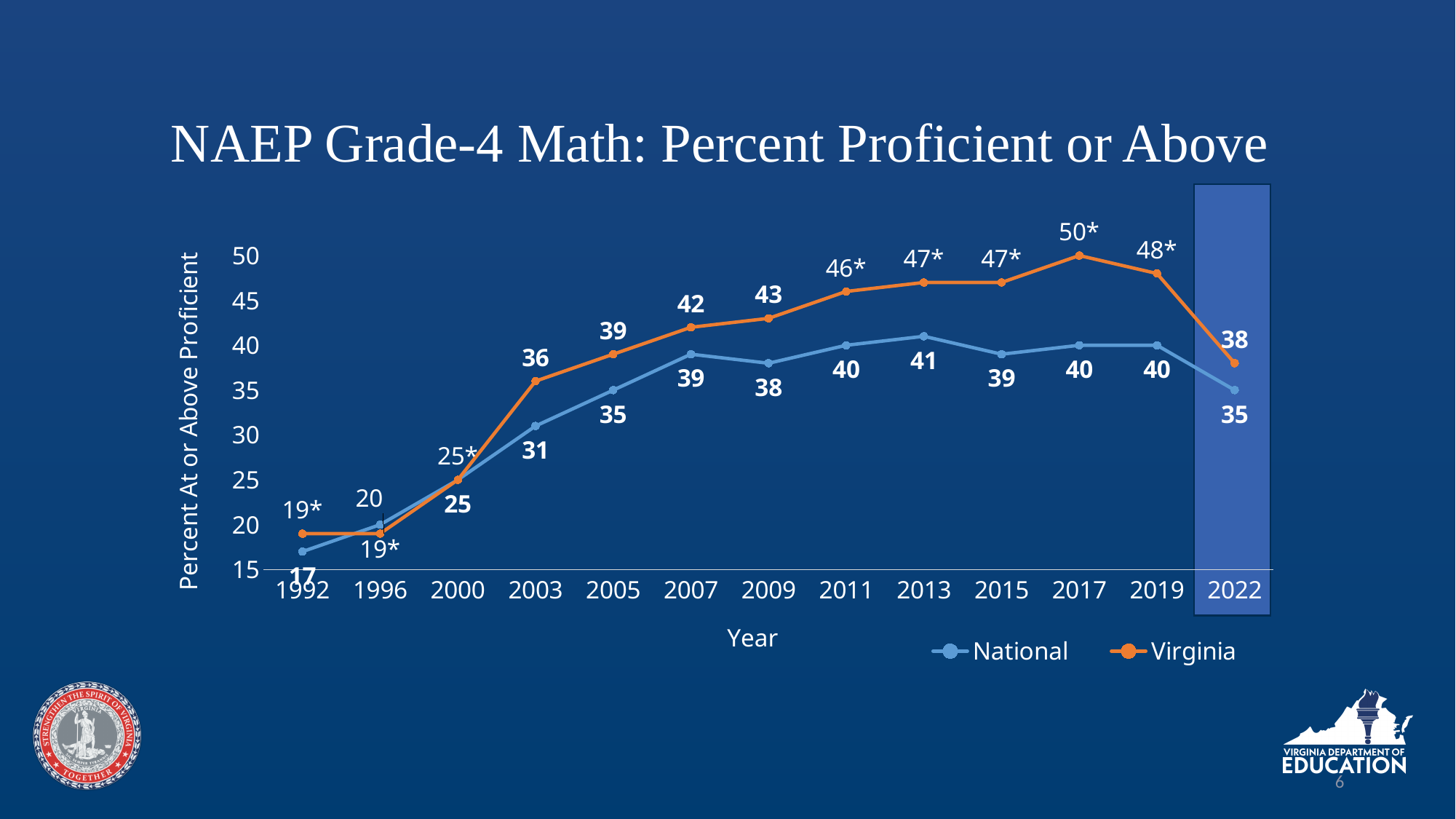
How many years are plotted along the x axis? 13 What is the difference between the Virginia and National values in 2022? 3 What is the label on the y axis? Percent At or Above Proficient What is the Virginia value for 2017? 50* In which year is the National value lowest? 1992 What is the Virginia value for 2022? 38 Does the National line rise or fall from 1992 to 2007? rise What kind of chart is shown on the slide? line chart How many series does the legend list? 2 In 2017, which series has the larger value, National or Virginia? Virginia What is the National value for 2013? 41 In which year is the Virginia value highest? 2017